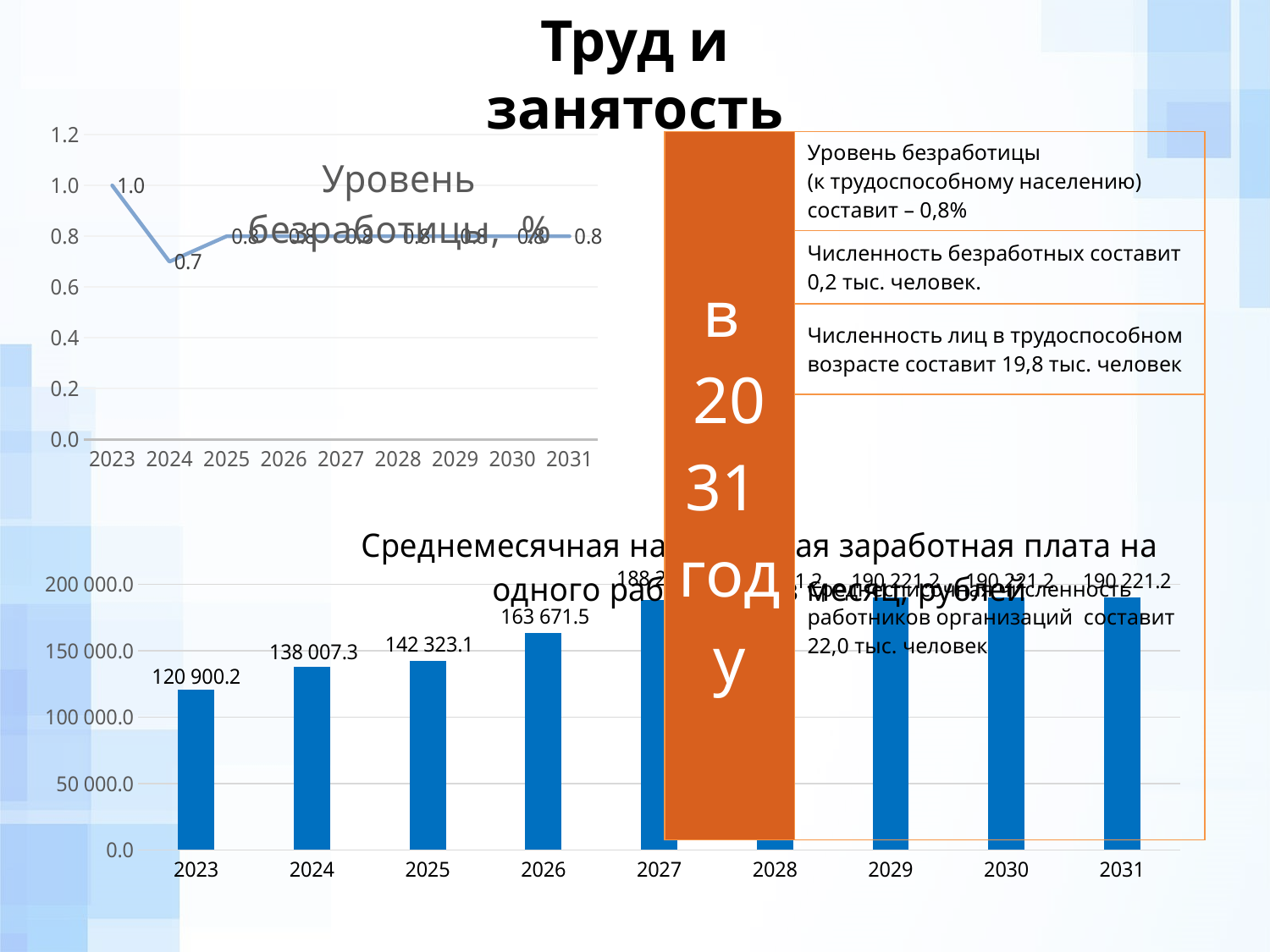
In the bottom bar chart of average monthly wages, what is the value for 2026? 163 671.5 How many years are plotted on the x axis of the line chart 'Уровень безработицы, %'? 9 In the line chart 'Уровень безработицы, %', which year has the lowest value? 2024 What kind of chart is the bottom chart of average monthly wages? bar chart In the bottom bar chart of average monthly wages, what is the value for 2023? 120 900.2 In the bottom bar chart of average monthly wages, what is the difference between the values for 2024 and 2023? 17 107.1 In the line chart 'Уровень безработицы, %', which year has the highest value? 2023 In the line chart 'Уровень безработицы, %', what is the value for 2023? 1.0 In the bottom bar chart of average monthly wages, what is the value for 2031? 190 221.2 In the line chart 'Уровень безработицы, %', what is the value for 2024? 0.7 What kind of chart is the top-left chart 'Уровень безработицы, %'? line chart In the bottom bar chart of average monthly wages, is the value for 2023 greater or less than 150 000.0? less